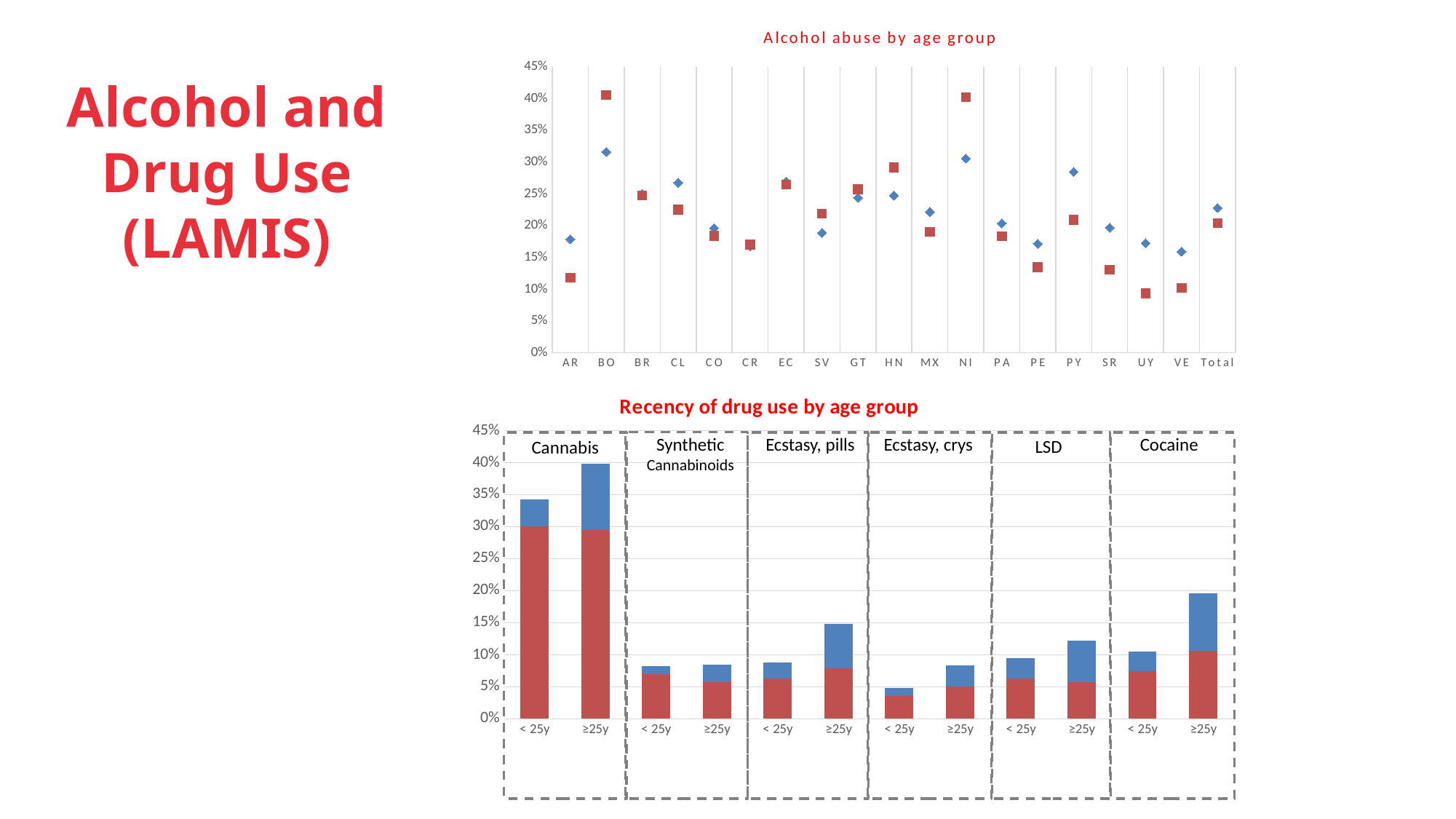
In the bottom chart 'Recency of drug use by age group', how many drug categories are labelled? 6 In the top chart 'Alcohol abuse by age group', which is larger for PE, the blue diamond or the red square? blue diamond In the top chart 'Alcohol abuse by age group', how many categories are shown on the x axis, including Total? 19 In the top chart 'Alcohol abuse by age group', is the red square value for AR greater or less than 15%? less In the bottom chart 'Recency of drug use by age group', is the total for Cannabis < 25y greater or less than 30%? greater In the top chart 'Alcohol abuse by age group', is the red square value for BO greater or less than 35%? greater In the bottom chart 'Recency of drug use by age group', which bar has the highest total? Cannabis ≥25y In the bottom chart 'Recency of drug use by age group', which bar has the lowest total? Ecstasy, crys < 25y What is the title of the top chart? Alcohol abuse by age group In the bottom chart 'Recency of drug use by age group', which has the larger total, Ecstasy, pills ≥25y or LSD ≥25y? Ecstasy, pills ≥25y What kind of chart is the bottom chart 'Recency of drug use by age group'? stacked bar chart